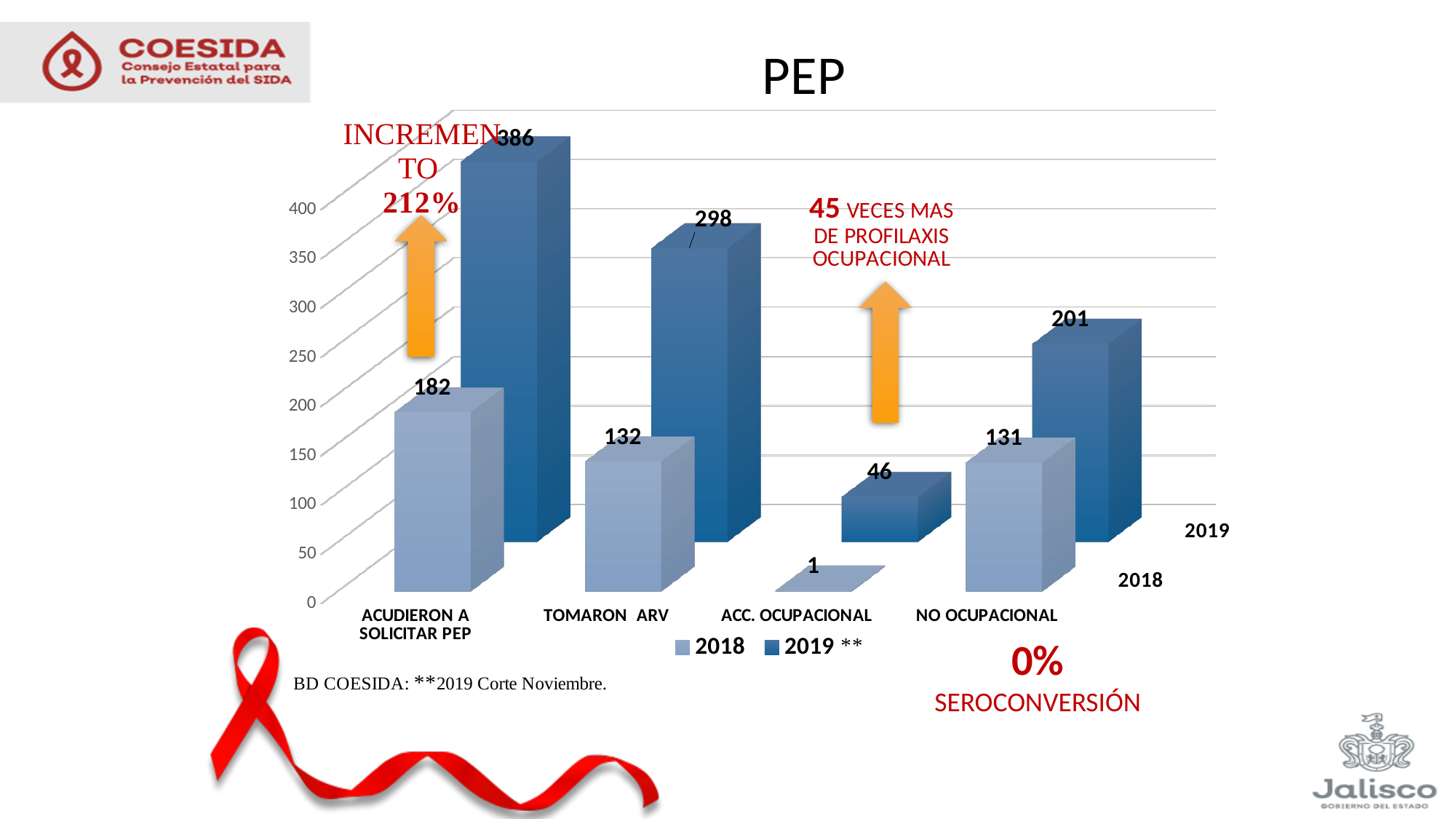
How many series does the legend list? 2 What is the 2018 value for ACC. OCUPACIONAL? 1 Which category has the lowest 2018 value? ACC. OCUPACIONAL How many categories are shown on the x axis? 4 What kind of chart is shown? bar chart Which category has the highest 2019 value? ACUDIERON A SOLICITAR PEP What is the difference between the 2019 and 2018 values for ACUDIERON A SOLICITAR PEP? 204 What is the title of the chart? PEP What is the 2019 value for NO OCUPACIONAL? 201 Which is larger, the 2019 value for TOMARON ARV or the 2019 value for NO OCUPACIONAL? TOMARON ARV What is the 2018 value for TOMARON ARV? 132 What is the 2019 value for ACUDIERON A SOLICITAR PEP? 386